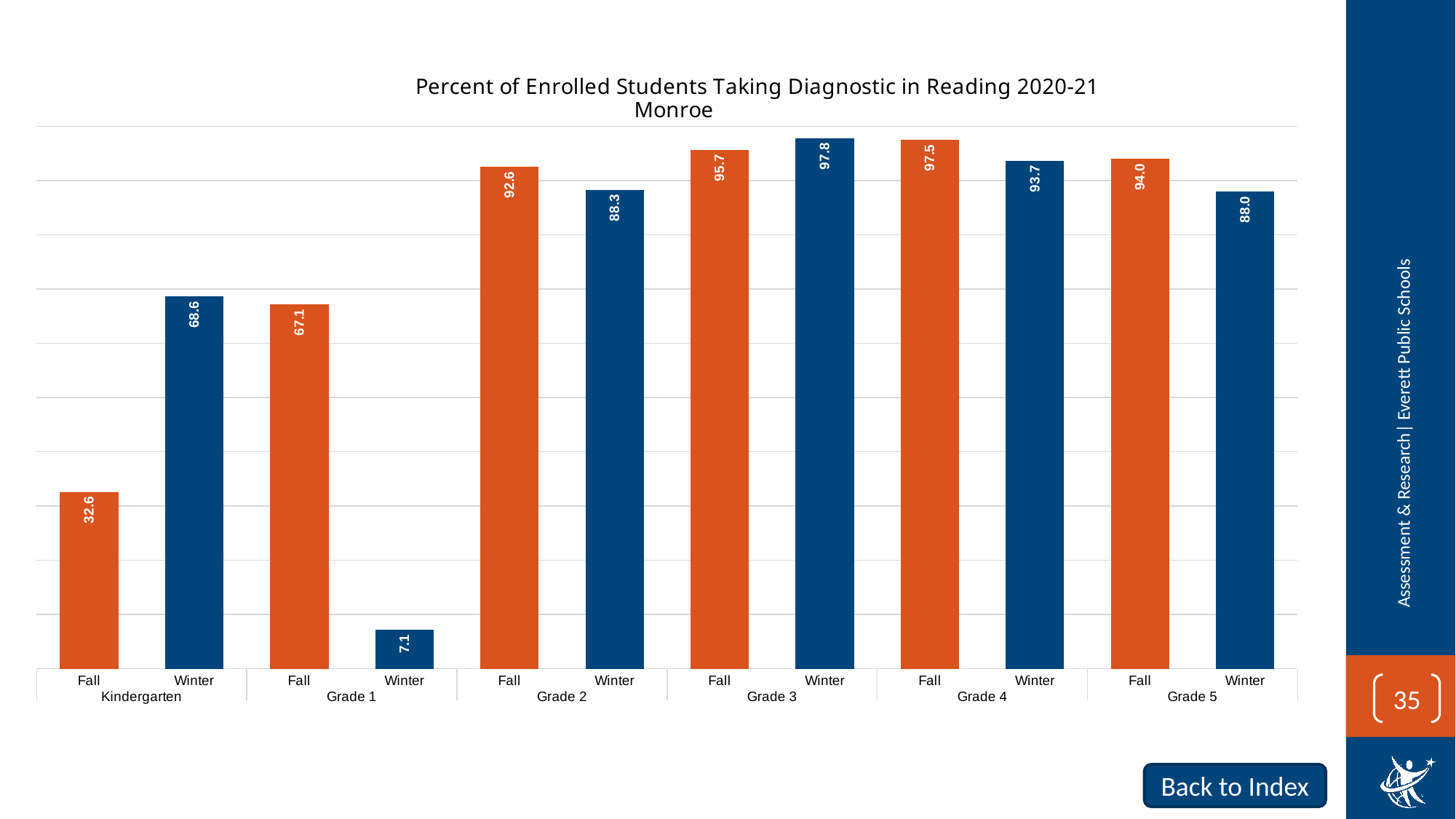
What is the difference between the Winter and Fall values for Kindergarten? 36.0 How many grade levels are shown on the x axis? 6 Which bar has the highest value on the chart? Grade 3 Winter What is the difference between the Fall and Winter values for Grade 2? 4.3 Which bar has the lowest value on the chart? Grade 1 Winter What kind of chart is this? Bar chart Which is larger, the Fall value for Grade 4 or the Winter value for Grade 4? Fall What is the value for Winter in Grade 3? 97.8 What is the title of the chart? Percent of Enrolled Students Taking Diagnostic in Reading 2020-21 Monroe What is the value for Fall in Kindergarten? 32.6 What is the value for Fall in Grade 5? 94.0 What is the value for Winter in Grade 1? 7.1